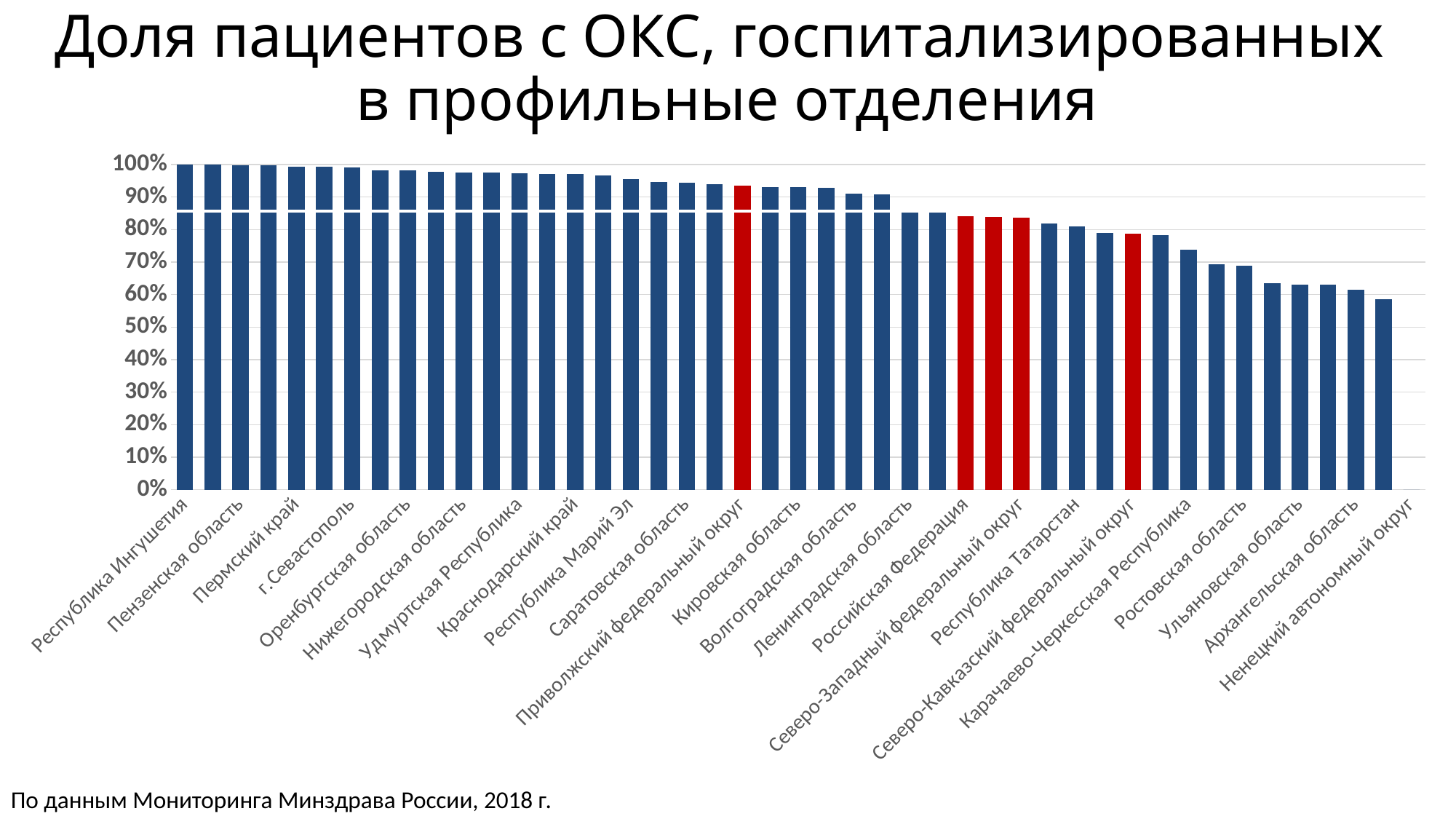
Do the values rise or fall from left to right along the x axis? fall Is the value for Ненецкий автономный округ greater or less than 70%? less What is the title of the chart? Доля пациентов с ОКС, госпитализированных в профильные отделения Is the value for Российская Федерация greater or less than 90%? less What is the maximum value shown on the y axis? 100% Which is larger, the value for Республика Ингушетия or the value for Ненецкий автономный округ? Республика Ингушетия Is the value for Республика Ингушетия greater or less than 90%? greater How many bars are highlighted in red? 5 What kind of chart is shown on the slide? bar chart Which category has the highest value? Республика Ингушетия Which category has the lowest value? Ненецкий автономный округ